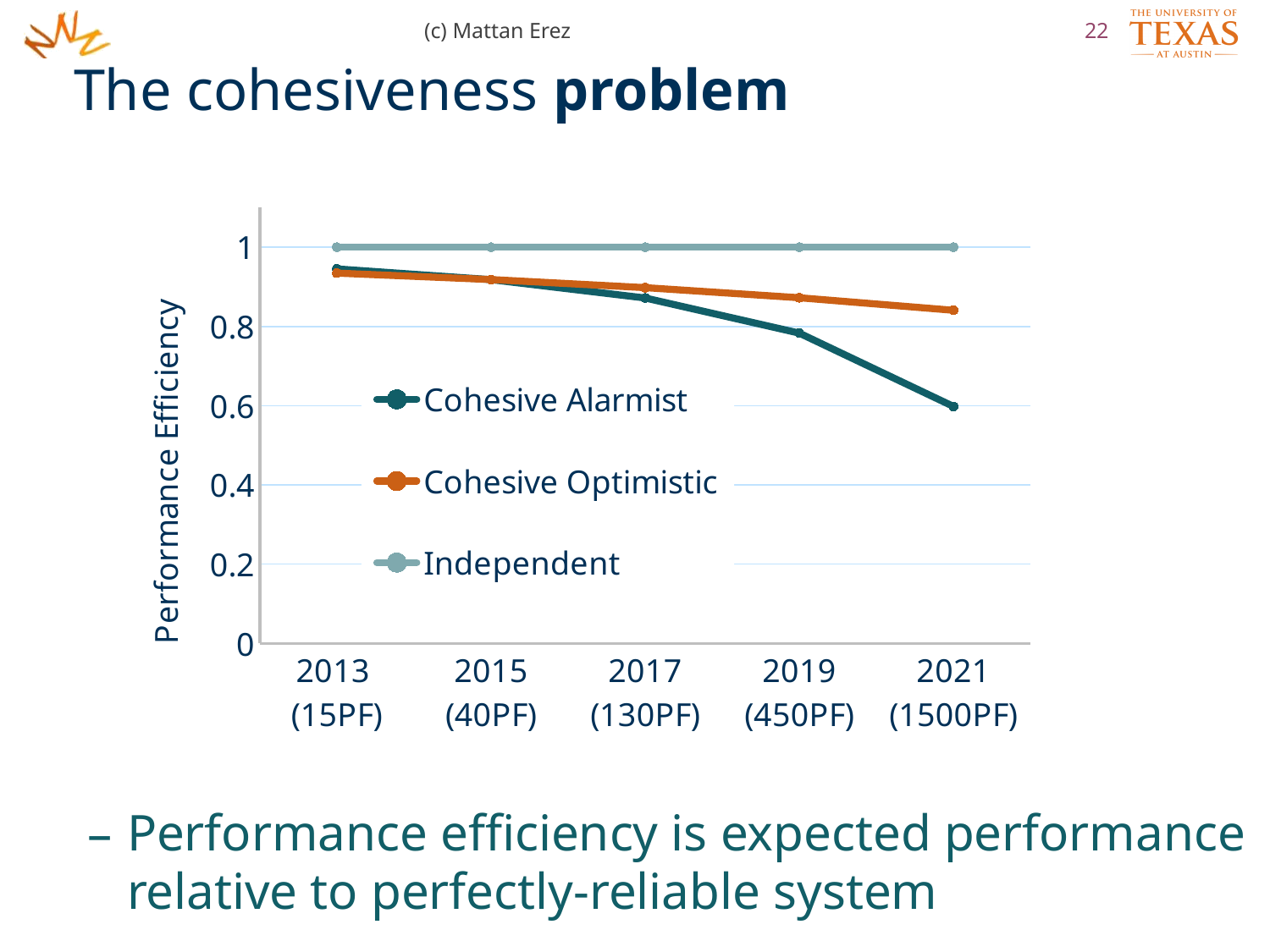
What is the label on the y axis? Performance Efficiency How many series does the legend list? 3 What is the value of the Independent series at 2021 (1500PF)? 1 How many points are plotted along the x axis for each series? 5 What kind of chart is shown on the slide? line chart Is the value for Cohesive Optimistic at 2021 (1500PF) greater or less than 0.8? greater At 2021 (1500PF), which is larger: Cohesive Optimistic or Cohesive Alarmist? Cohesive Optimistic Is the value for Cohesive Alarmist at 2017 (130PF) greater or less than 0.8? greater Which series has the lowest value at 2021 (1500PF)? Cohesive Alarmist Which series has the highest value at 2021 (1500PF)? Independent Does the Cohesive Alarmist series rise or fall from 2013 to 2021? fall